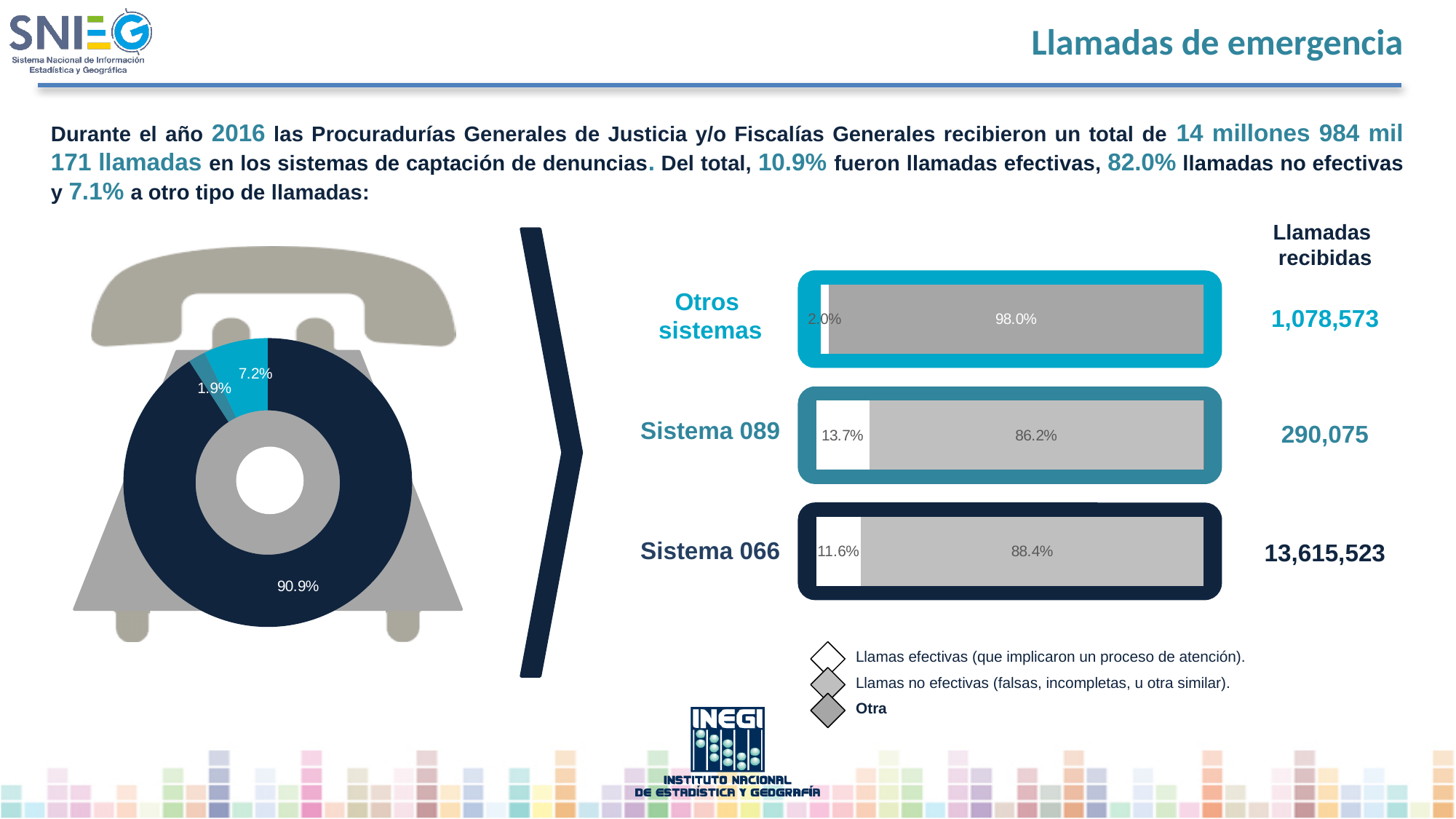
In the donut chart on the left, what is the value of the smallest slice? 1.9% How many slices does the donut chart on the left have? 3 In the donut chart on the left, what is the value of the largest slice? 90.9% In the bar chart on the right, how many calls (Llamadas recibidas) did Sistema 066 receive? 13,615,523 In the bar chart on the right, what percentage of calls to Sistema 089 were effective (Llamas efectivas)? 13.7% In the bar chart on the right, which system received the fewest calls (Llamadas recibidas)? Sistema 089 In the bar chart on the right, what percentage of calls to Sistema 066 were not effective (Llamas no efectivas)? 88.4% In the bar chart on the right, what percentage of calls to Otros sistemas were not effective? 98.0% In the bar chart on the right, which system has the highest share of effective calls? Sistema 089 How many categories does the legend of the bar chart on the right list? 3 What kind of chart is shown on the left side of the slide, inside the telephone graphic? Pie (donut) chart In the bar chart on the right, what is the difference between the effective-call percentages of Sistema 089 and Sistema 066? 2.1%